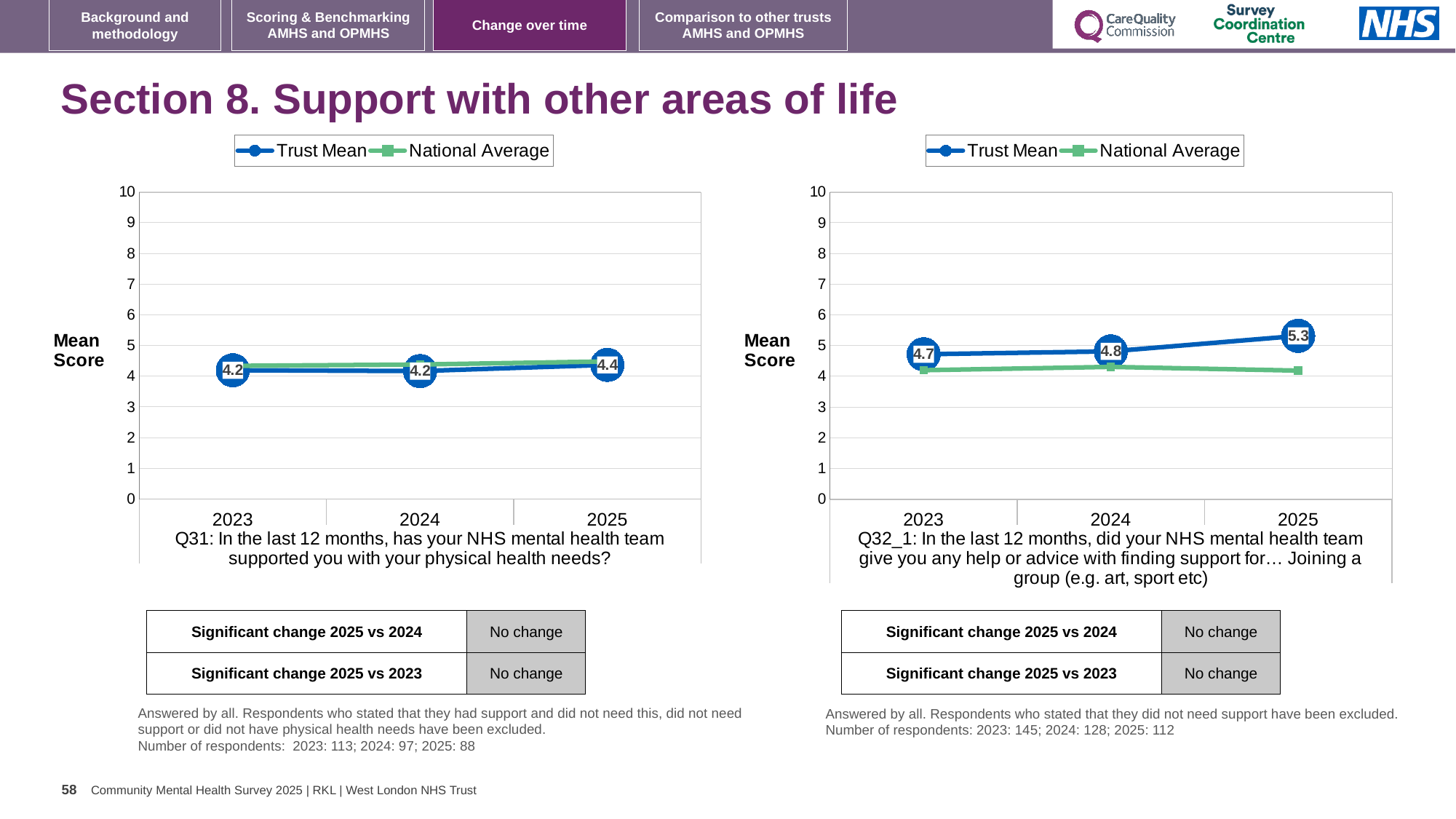
On the left chart (Q31), what is the Trust Mean score for 2025? 4.4 On the right chart (Q32_1), what is the difference between the Trust Mean scores for 2025 and 2023? 0.6 On the right chart (Q32_1), what is the Trust Mean score for 2024? 4.8 On the right chart (Q32_1), is the Trust Mean for 2025 greater or less than 5? greater On the left chart (Q31), what is the Trust Mean score for 2023? 4.2 On the right chart (Q32_1), which year has the highest Trust Mean score? 2025 How many series does the legend of the left chart (Q31) list? 2 On the left chart (Q31), what is the difference between the Trust Mean scores for 2025 and 2024? 0.2 On the right chart (Q32_1), which is larger in 2025, the Trust Mean or the National Average? Trust Mean On the right chart (Q32_1), is the National Average for 2025 greater or less than 5? less On the right chart (Q32_1), what is the Trust Mean score for 2025? 5.3 What type of chart is used for Q32_1 on the right? Line chart